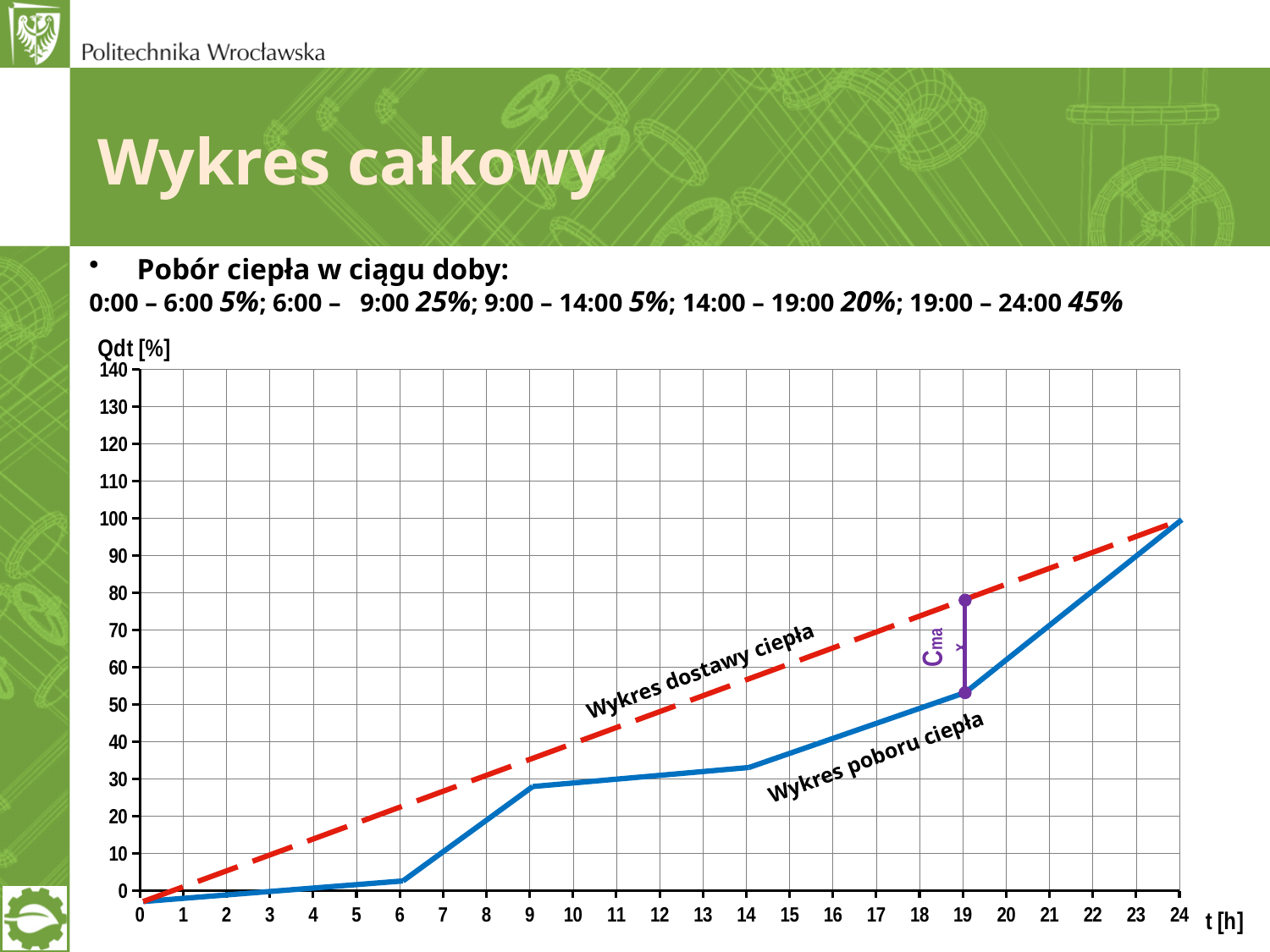
What are the names of the two series plotted on the chart? Wykres dostawy ciepła and Wykres poboru ciepła Is the value of Wykres dostawy ciepła at t = 18 greater or less than 60? greater At which value of t is the vertical segment labelled Cmax drawn between the two series? 19 Is the value of Wykres poboru ciepła at t = 14 greater or less than 40? less What kind of chart is shown on the slide? line chart Is the value of Wykres poboru ciepła at t = 19 greater or less than 40? greater At t = 19, which series has the higher value, Wykres dostawy ciepła or Wykres poboru ciepła? Wykres dostawy ciepła At t = 6, which series has the higher value, Wykres dostawy ciepła or Wykres poboru ciepła? Wykres dostawy ciepła Do the values of the Wykres poboru ciepła series rise or fall as t increases from 0 to 24? rise How many data series are plotted on the chart? 2